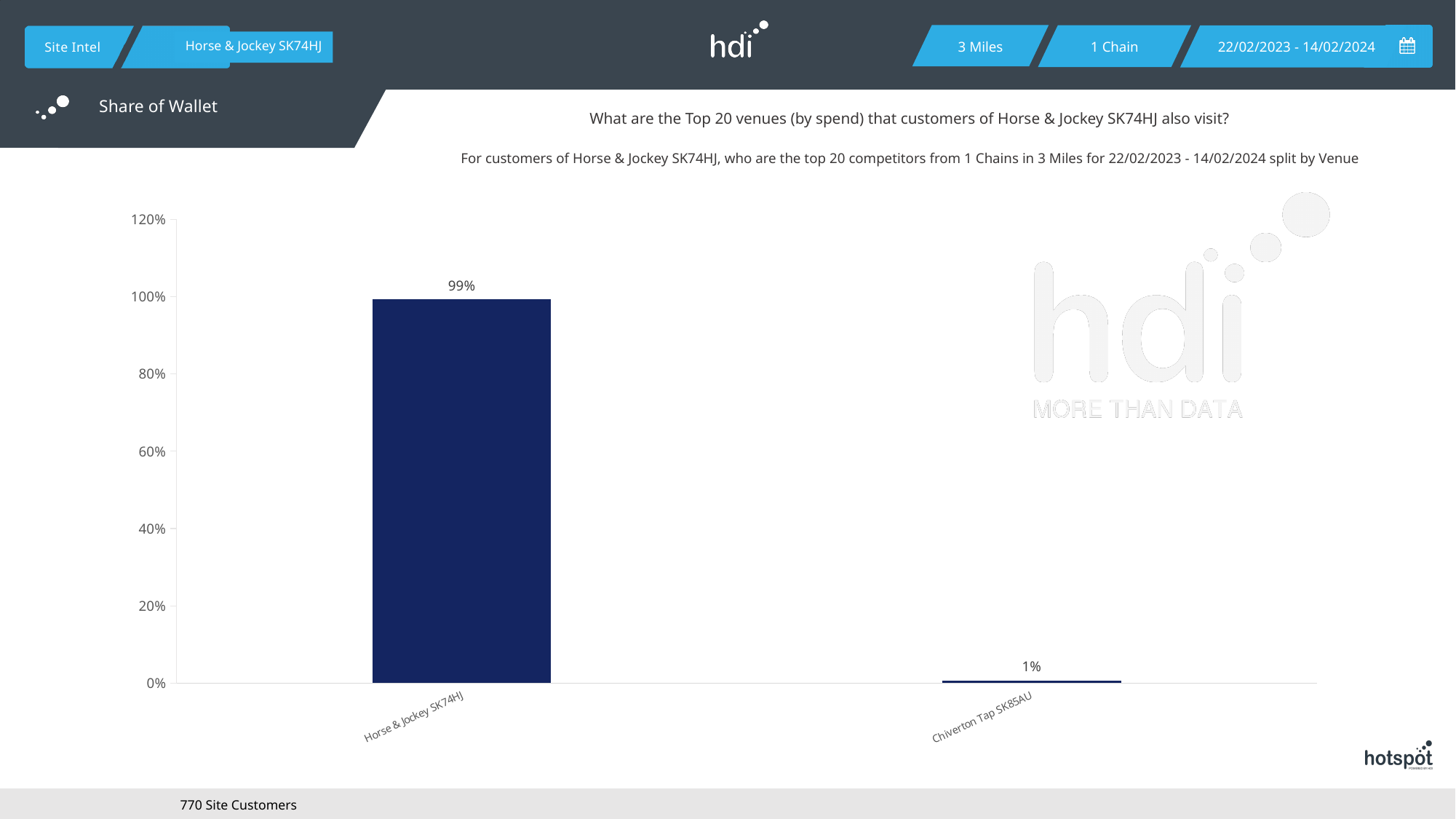
What is the difference between the values for Horse & Jockey SK74HJ and Chiverton Tap SK85AU? 98% How many venues are shown on the chart? 2 How many site customers are stated at the bottom of the slide? 770 Is the value for Horse & Jockey SK74HJ greater or less than 80%? greater What is the value for Horse & Jockey SK74HJ? 99% Which venue has the lowest value? Chiverton Tap SK85AU What is the value for Chiverton Tap SK85AU? 1% Which venue has the highest value? Horse & Jockey SK74HJ What kind of chart is shown on the slide? Bar chart Is the value for Chiverton Tap SK85AU greater or less than 20%? less What is the highest value shown on the y axis? 120% Which is larger, the value for Horse & Jockey SK74HJ or for Chiverton Tap SK85AU? Horse & Jockey SK74HJ